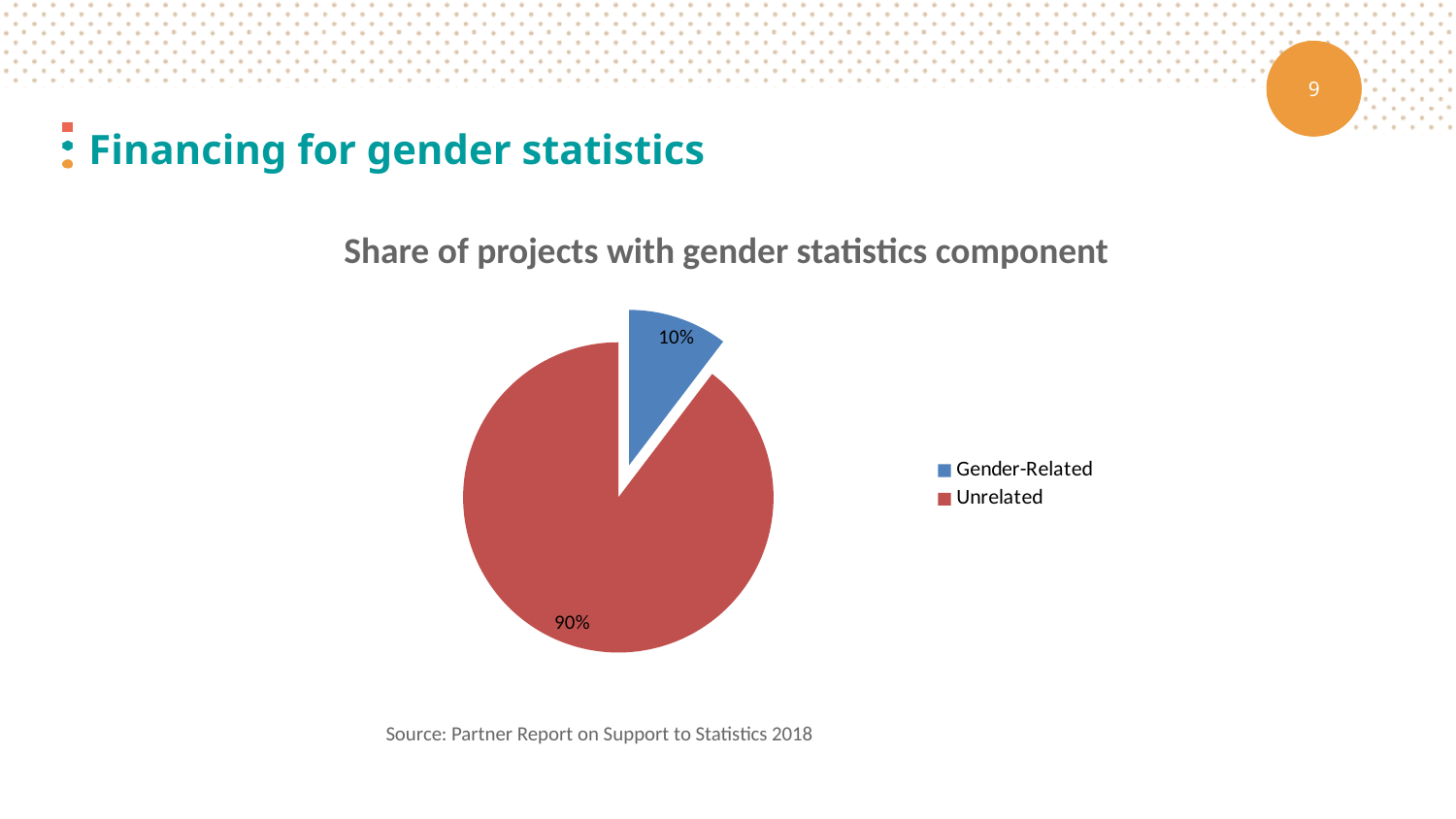
How many entries does the legend list? 2 Which category has the smallest share of the pie? Gender-Related What share of projects is Gender-Related? 10% What kind of chart is shown on the slide? pie chart Which category has the largest share of the pie? Unrelated What is the difference in percentage points between the Unrelated and Gender-Related shares? 80 percentage points What is the total of the two slices shown? 100% What share of projects is Unrelated? 90% What is the title of the chart? Share of projects with gender statistics component How many categories does the pie chart show? 2 What colour is the Gender-Related slice? blue Which is larger, the Gender-Related share or the Unrelated share? Unrelated